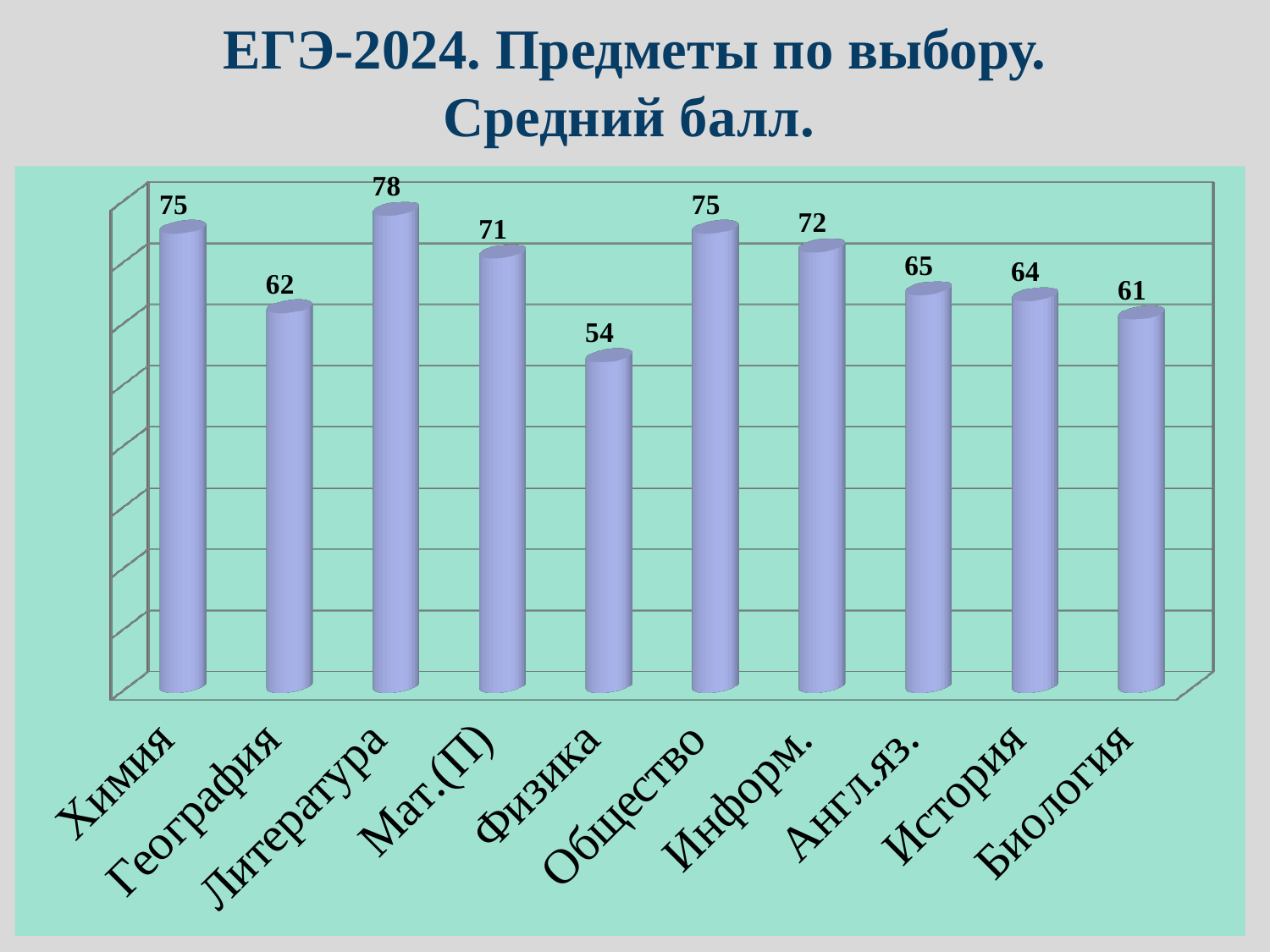
Which subject has the highest average score? Литература Which subject has the lowest average score? Физика What kind of chart is shown on the slide? Bar chart Which has a higher average score, Мат.(П) or Англ.яз.? Мат.(П) What is the average score for Литература? 78 What is the average score for Физика? 54 How many subjects are shown in the chart? 10 What is the difference between the average scores for Химия and География? 13 What is the average score for Информ.? 72 What is the difference between the average scores for Литература and Физика? 24 Which has a higher average score, История or Биология? История What is the title of the slide? ЕГЭ-2024. Предметы по выбору. Средний балл.